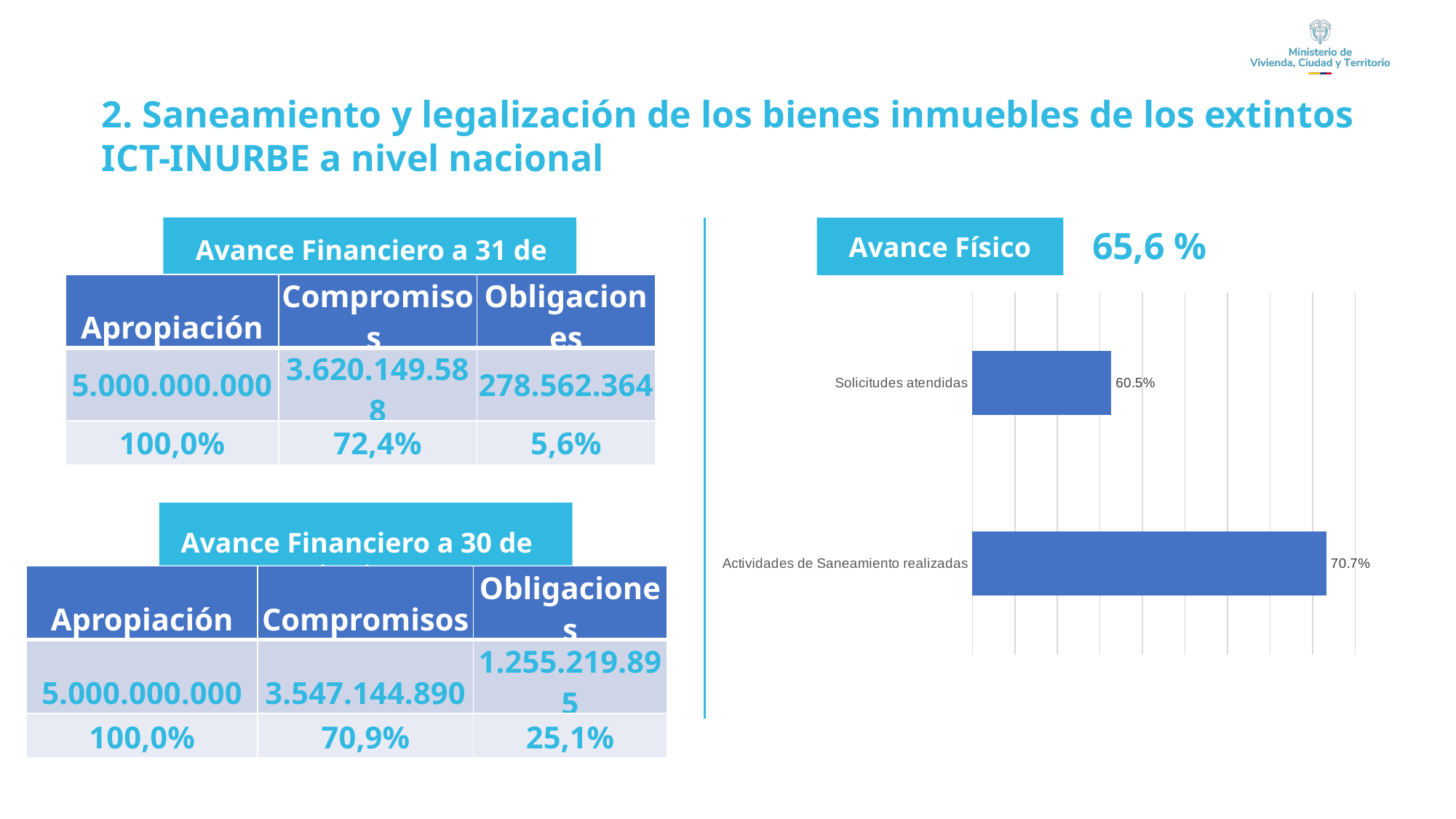
What is the heading shown above the bar chart? Avance Físico What is the value for Solicitudes atendidas in the bar chart? 60.5% Which is larger in the bar chart: Solicitudes atendidas or Actividades de Saneamiento realizadas? Actividades de Saneamiento realizadas How many categories are shown in the bar chart? 2 Which category has the lowest value in the bar chart? Solicitudes atendidas What kind of chart is shown on the right side of the slide? Bar chart What overall percentage is displayed next to the Avance Físico heading above the bar chart? 65,6 % What is the difference between the values for Actividades de Saneamiento realizadas and Solicitudes atendidas in the bar chart? 10.2% Which category has the highest value in the bar chart? Actividades de Saneamiento realizadas What is the value for Actividades de Saneamiento realizadas in the bar chart? 70.7%